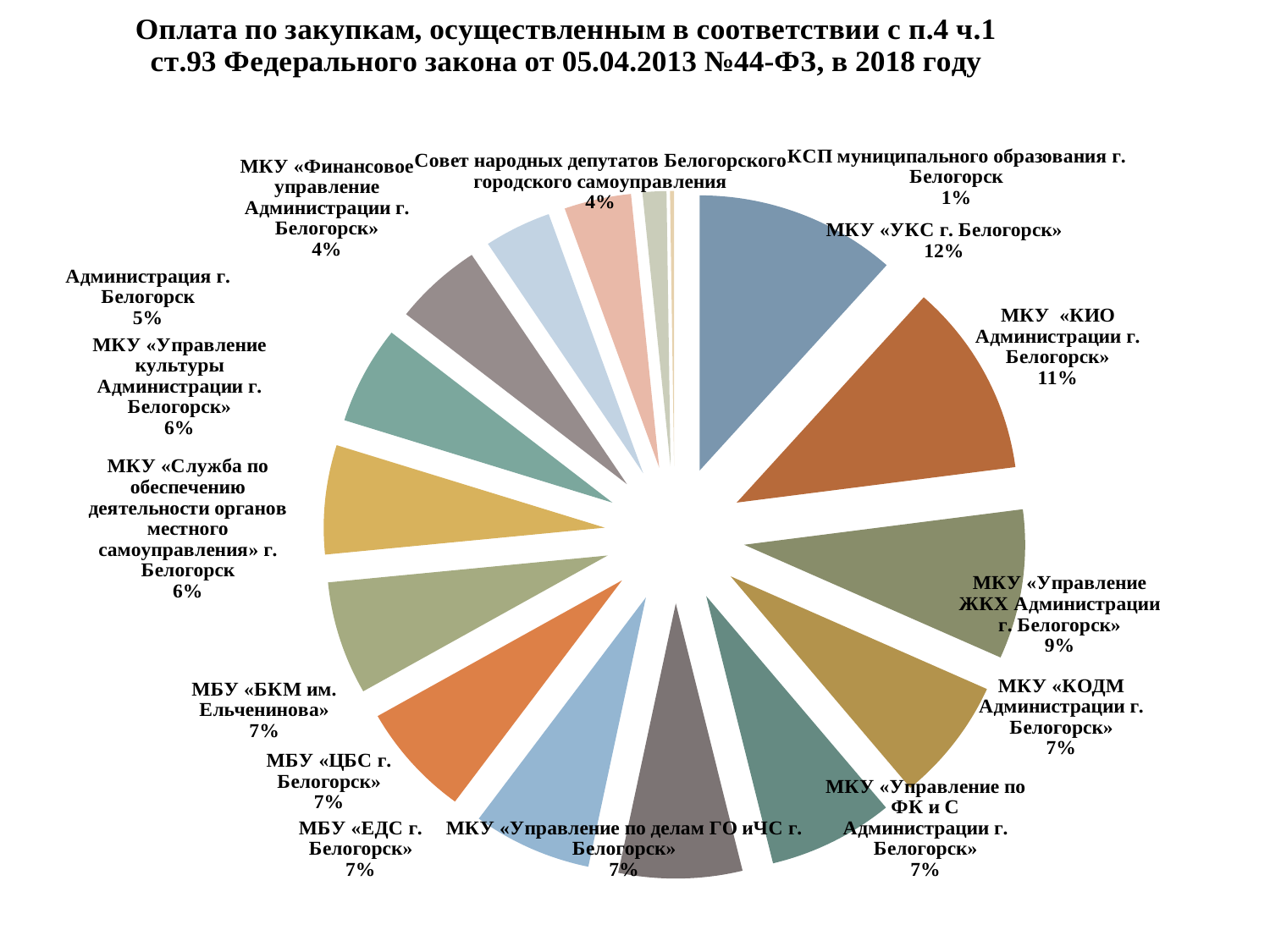
Which is larger: the share of МКУ «Управление ЖКХ Администрации г. Белогорск» or МКУ «КОДМ Администрации г. Белогорск»? МКУ «Управление ЖКХ Администрации г. Белогорск» What is the value shown for МКУ «КИО Администрации г. Белогорск»? 11% What is the value shown for МКУ «Финансовое управление Администрации г. Белогорск»? 4% Which labelled category has the smallest share of the pie? КСП муниципального образования г. Белогорск What is the difference between the shares of МКУ «УКС г. Белогорск» and МКУ «КИО Администрации г. Белогорск»? 1% What is the value shown for КСП муниципального образования г. Белогорск? 1% What is the value shown for Администрация г. Белогорск? 5% Which labelled category has the largest share of the pie? МКУ «УКС г. Белогорск» Which year does the chart title say the data refers to? 2018 What share of the pie does МКУ «УКС г. Белогорск» have? 12% What is the value shown for МКУ «Управление ЖКХ Администрации г. Белогорск»? 9% What kind of chart is shown on the slide? pie chart